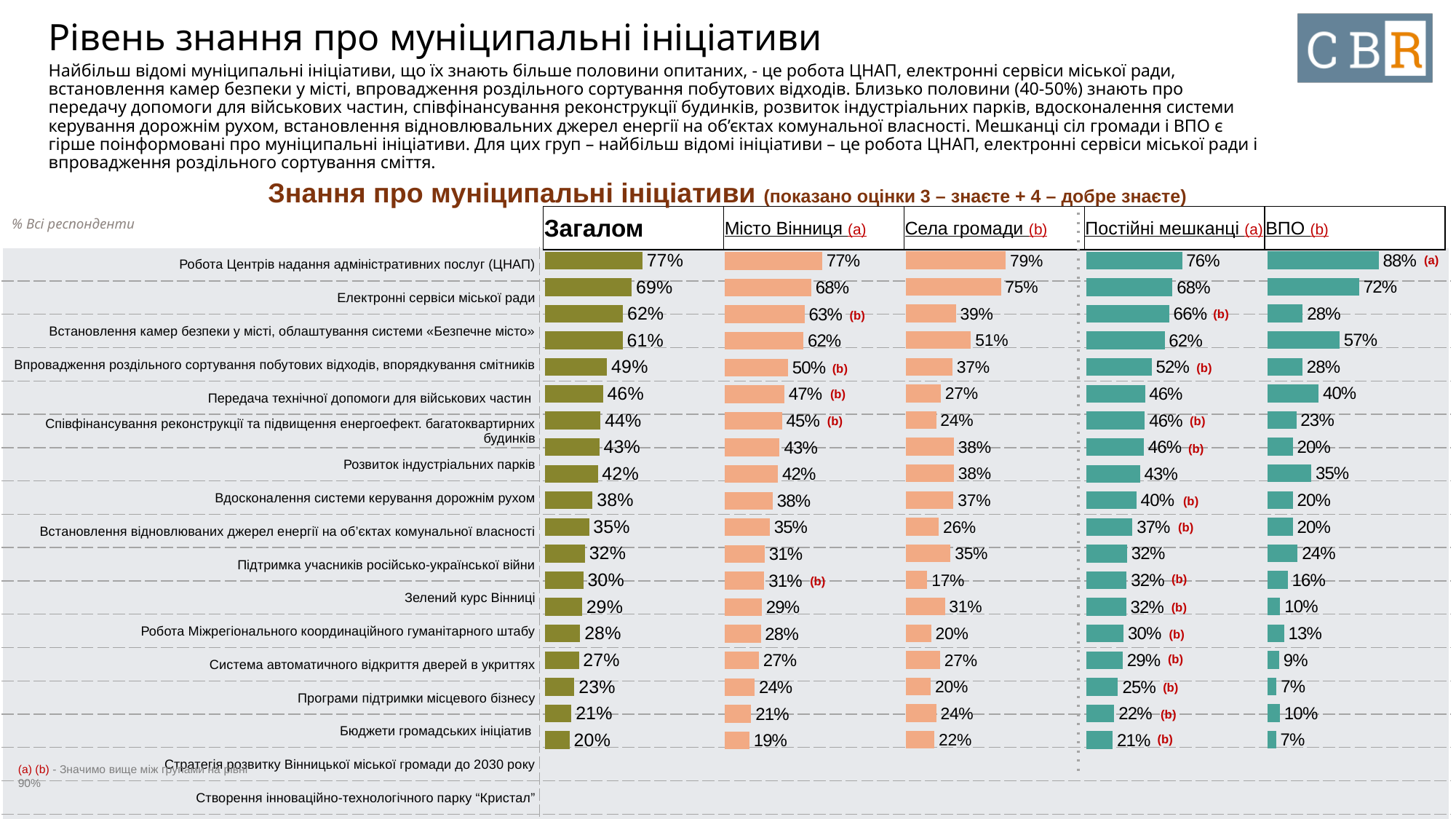
What is the title of the chart? Знання про муніципальні ініціативи What is the lowest value shown in the ВПО column? 7% Which initiative has the highest value in the Загалом column? Робота Центрів надання адміністративних послуг (ЦНАП) What kind of chart is used to show knowledge of municipal initiatives? bar chart For Робота ЦНАП, what is the difference between the ВПО value and the Постійні мешканці value? 12 percentage points In the ВПО column, what is the value for Робота Центрів надання адміністративних послуг (ЦНАП)? 88% What is the lowest value shown in the Загалом column? 20% For Робота ЦНАП, which group has the higher value: Постійні мешканці or ВПО? ВПО In the Загалом column, what is the value for Електронні сервіси міської ради? 69% In the Загалом column, what is the value for Робота Центрів надання адміністративних послуг (ЦНАП)? 77% How many respondent groups (columns) does the chart show? 5 In the Села громади column, what is the value for Робота Центрів надання адміністративних послуг (ЦНАП)? 79%